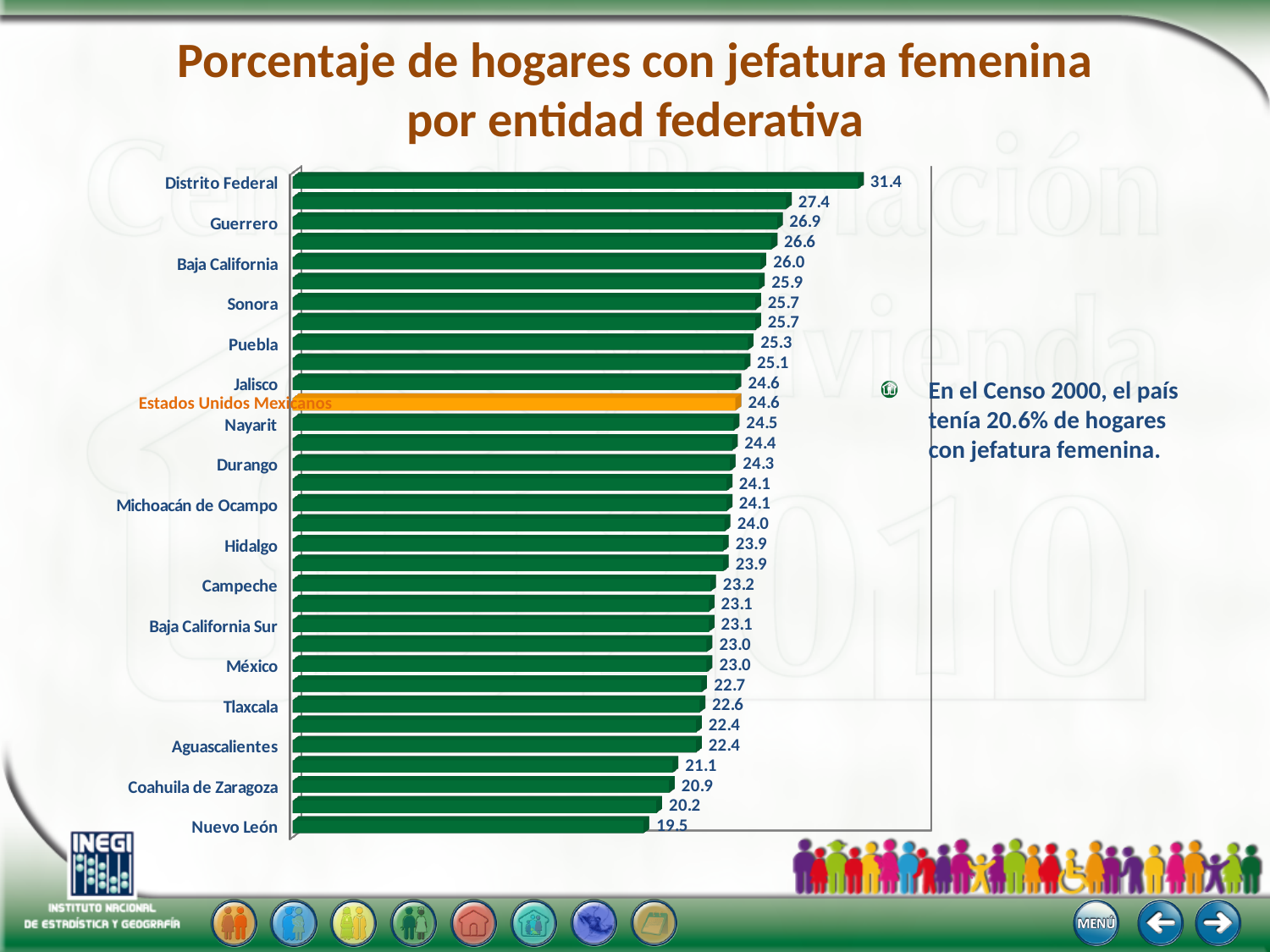
What is the value for Nuevo León? 19.5 What kind of chart is shown on the slide? Bar chart Which entity has the lowest value? Nuevo León What is the value for Estados Unidos Mexicanos? 24.6 Which has a larger value, Sonora or Puebla? Sonora Which entity has the highest value? Distrito Federal Which bar is highlighted in orange instead of green? Estados Unidos Mexicanos What is the difference between the values for Distrito Federal and Nuevo León? 11.9 What is the difference between the values for Guerrero and Baja California? 0.9 What is the value for Distrito Federal? 31.4 What is the value for Campeche? 23.2 What is the value for Guerrero? 26.9